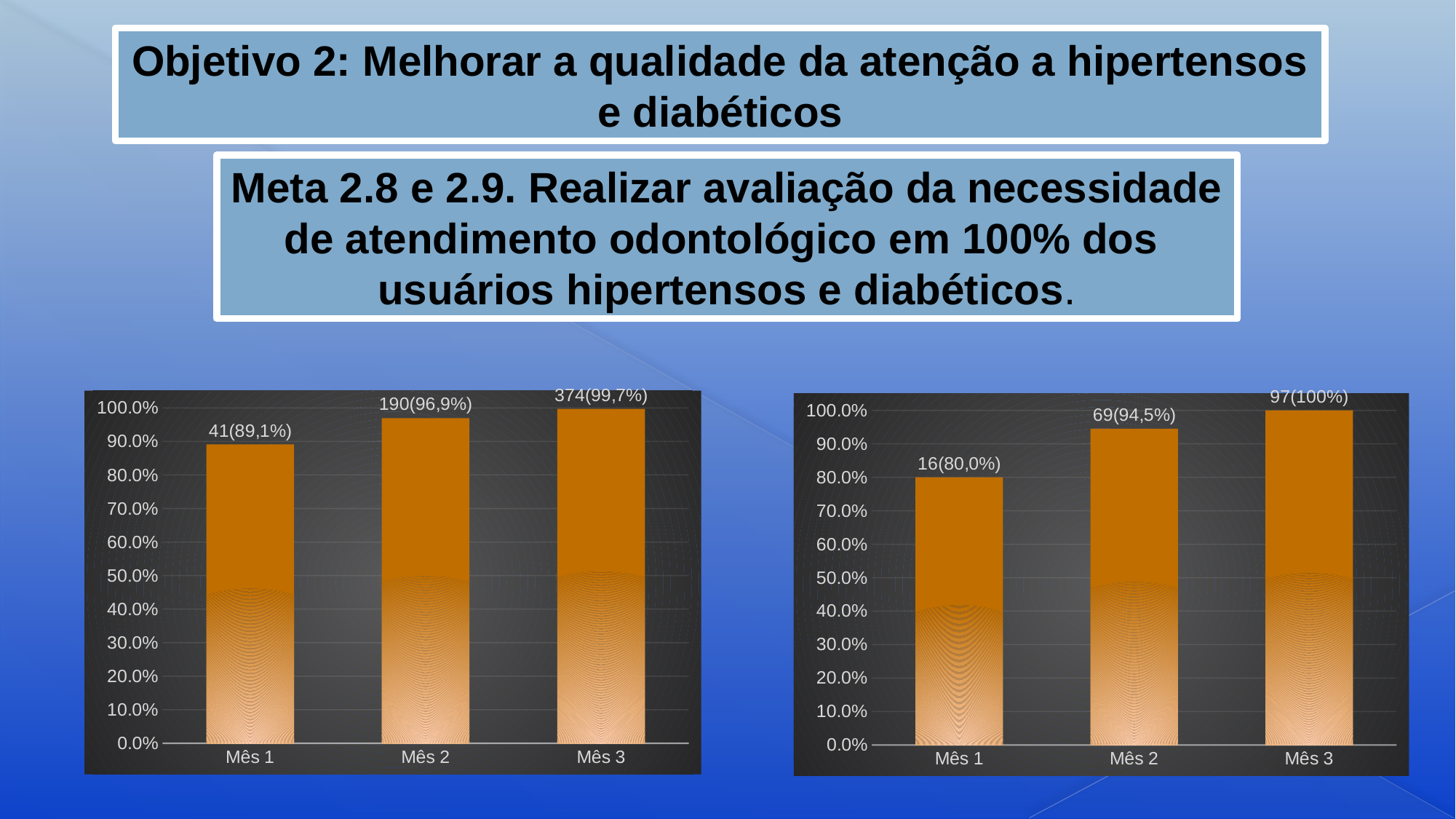
In the right chart, what is the difference in percentage points between Mês 3 and Mês 1? 20,0 In the left chart, what is the difference between the counts for Mês 3 and Mês 1? 333 How many months are shown on the x axis of the left chart? 3 In the left chart, what is the data label for Mês 3? 374(99,7%) In the left chart, which month has the lowest value? Mês 1 In the right chart, what is the data label for Mês 1? 16(80,0%) In the right chart, which is larger, the value for Mês 2 or Mês 1? Mês 2 In the right chart, which month has the highest value? Mês 3 In the left chart, do the values rise or fall from Mês 1 to Mês 3? rise What kind of chart is the right chart? bar chart In the left chart, what is the data label for Mês 2? 190(96,9%) In the right chart, is the value for Mês 1 greater or less than 90.0%? less